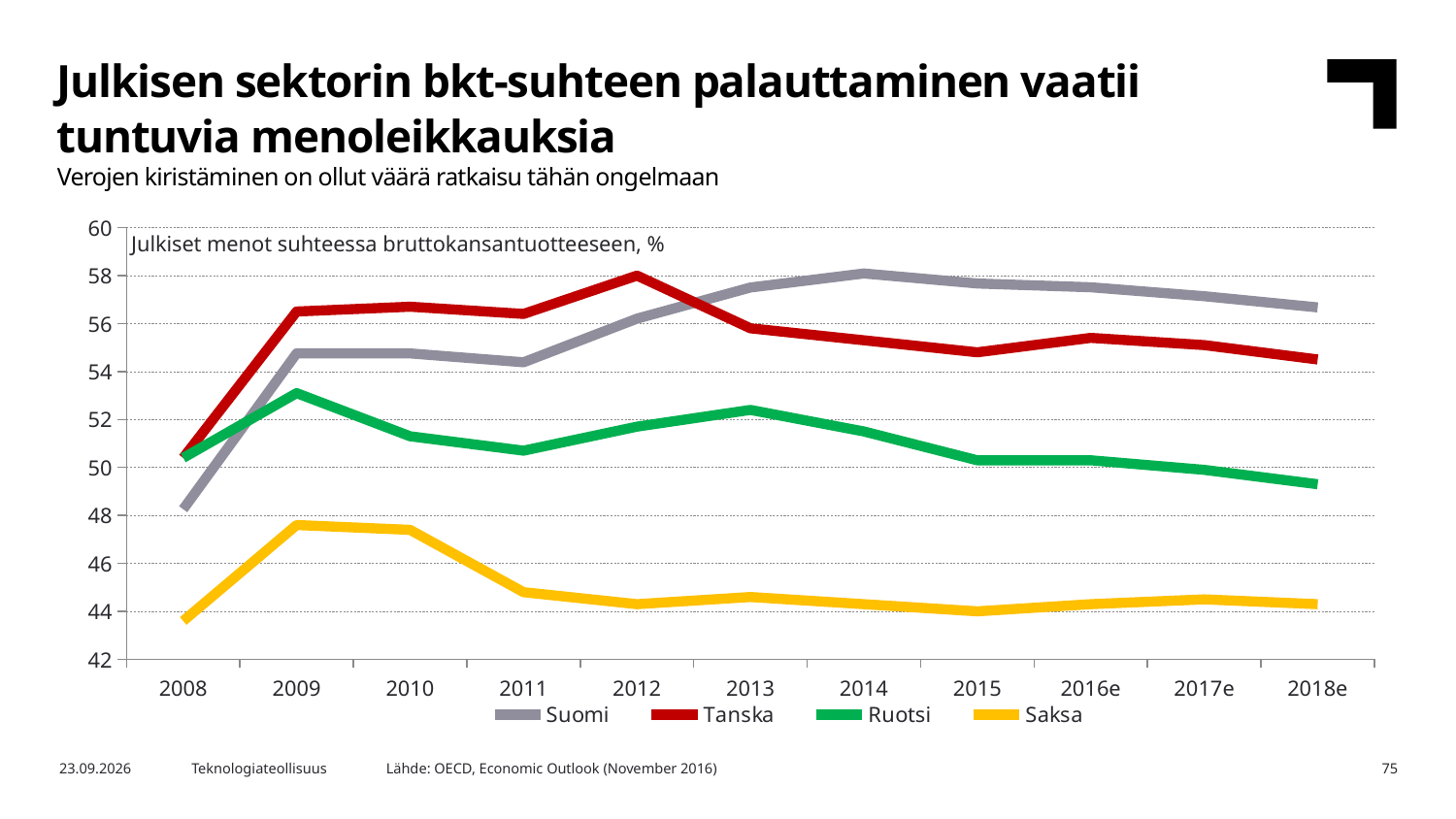
How many series does the legend list? 4 How many years are shown along the x axis? 11 Which is higher in 2009, Tanska or Suomi? Tanska What is the title printed inside the chart area? Julkiset menot suhteessa bruttokansantuotteeseen, % Which series has the lowest value in 2010? Saksa Which series has the highest value in 2016e? Suomi Which is higher in 2018e, Suomi or Tanska? Suomi Is the value for Suomi in 2008 greater or less than 50? less Is the value for Ruotsi in 2018e greater or less than 50? less Is the value for Saksa in 2009 greater or less than 46? greater What kind of chart is shown on the slide? line chart Does the Saksa line rise or fall from 2009 to 2011? fall